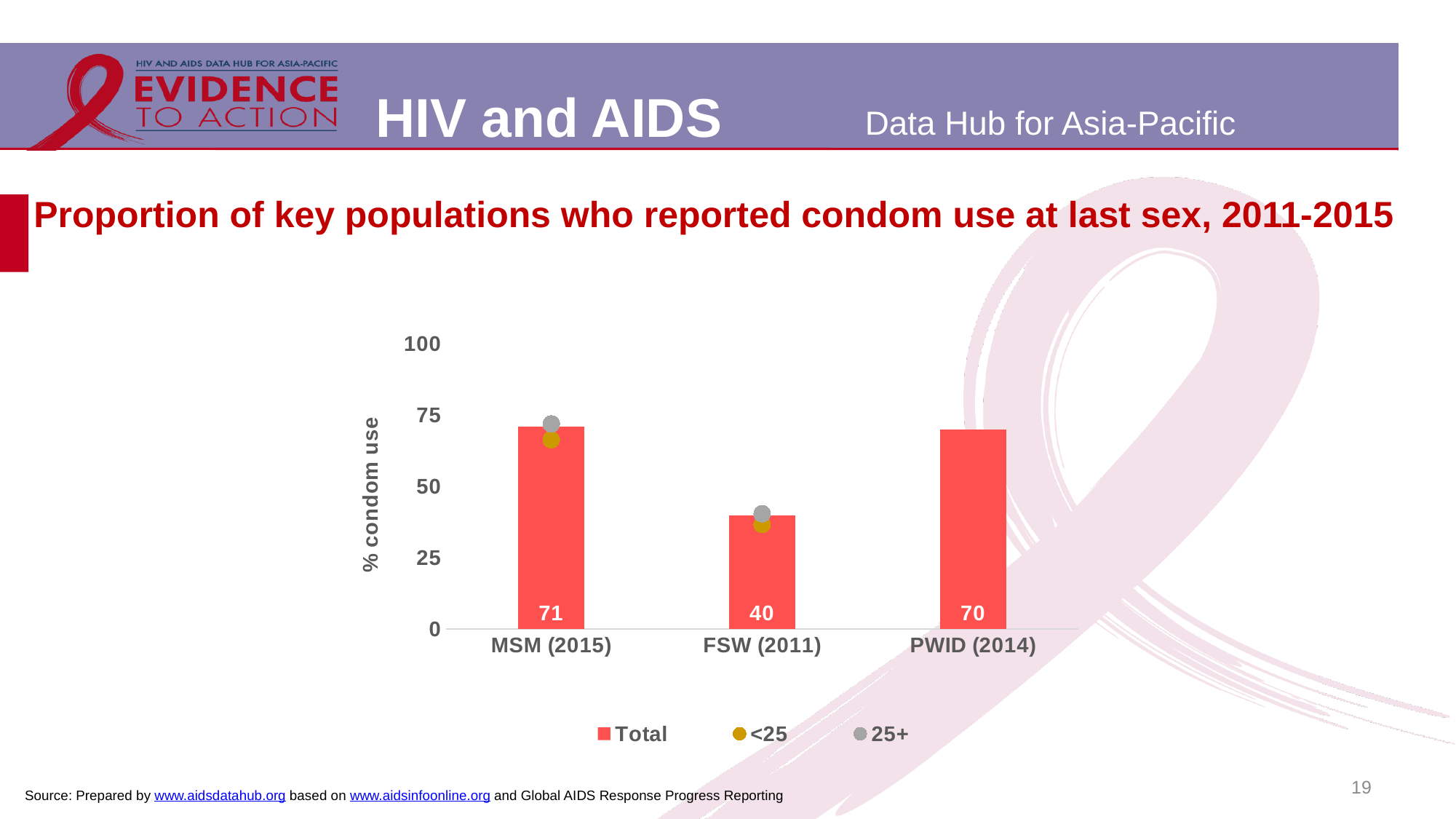
What is the difference between the Total values for MSM (2015) and FSW (2011)? 31 What type of chart is used to show the Total values? bar chart Which key population has the highest Total condom use? MSM (2015) What is the Total value for FSW (2011)? 40 What is the Total value for MSM (2015)? 71 How many series does the legend list? 3 What is the Total value for PWID (2014)? 70 Is the 25+ value for FSW (2011) greater or less than 50? less Is the Total value for FSW (2011) larger or smaller than the Total value for PWID (2014)? smaller Is the <25 value for MSM (2015) greater or less than 50? greater Which key population has the lowest Total condom use? FSW (2011) How many key population categories are shown on the x axis? 3